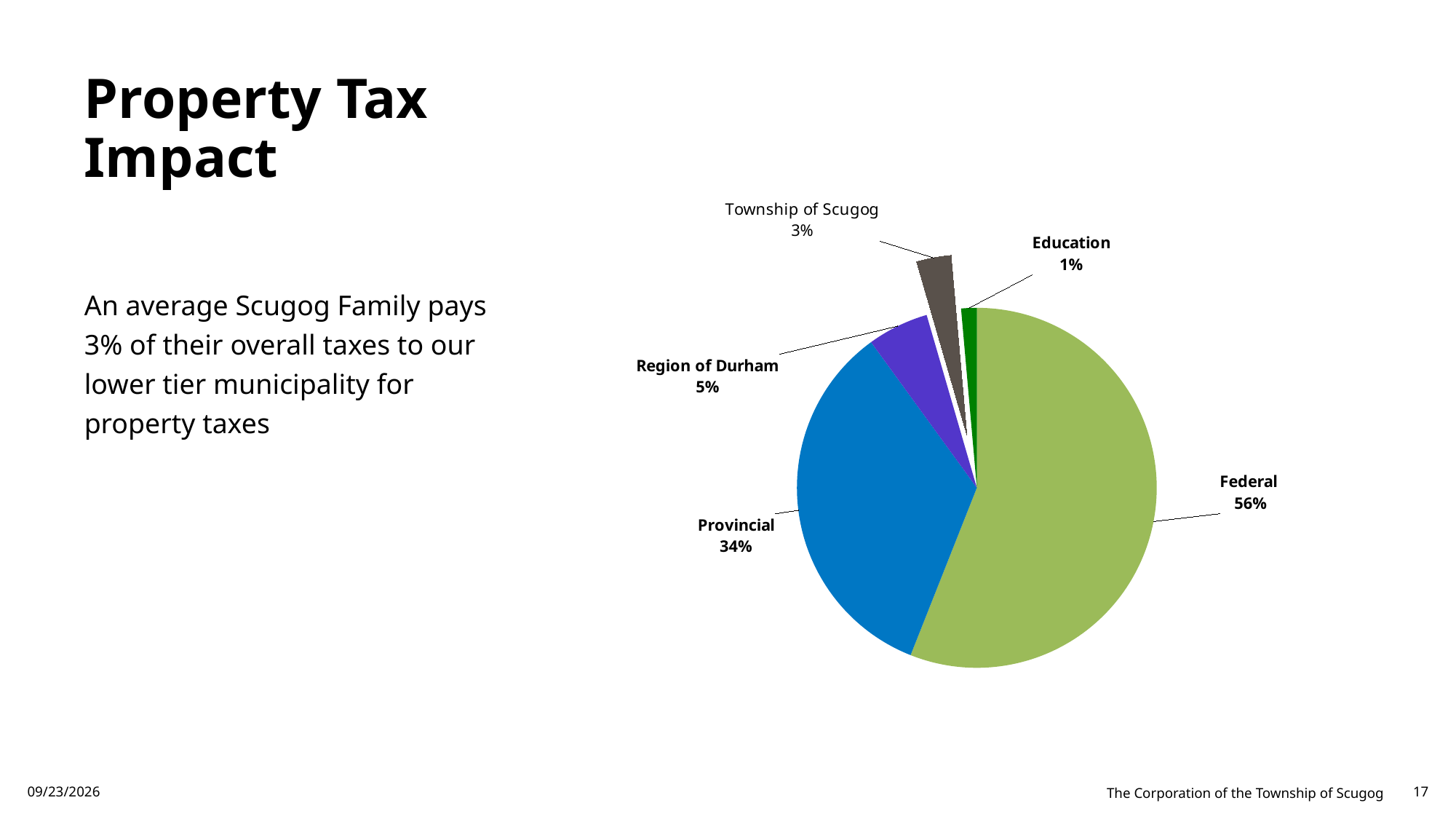
Which slice is pulled out (exploded) from the pie? Township of Scugog What is the value shown for Education? 1% What share of the pie does Federal account for? 56% What kind of chart is shown on the slide? Pie chart What is the difference between the Federal and Provincial shares? 22% What is the value shown for Provincial? 34% Which category has the smallest slice of the pie? Education What is the value shown for Township of Scugog? 3% What is the value shown for Region of Durham? 5% Which category has the largest slice of the pie? Federal Which is larger, Region of Durham or Township of Scugog? Region of Durham How many categories are shown in the pie chart? 5